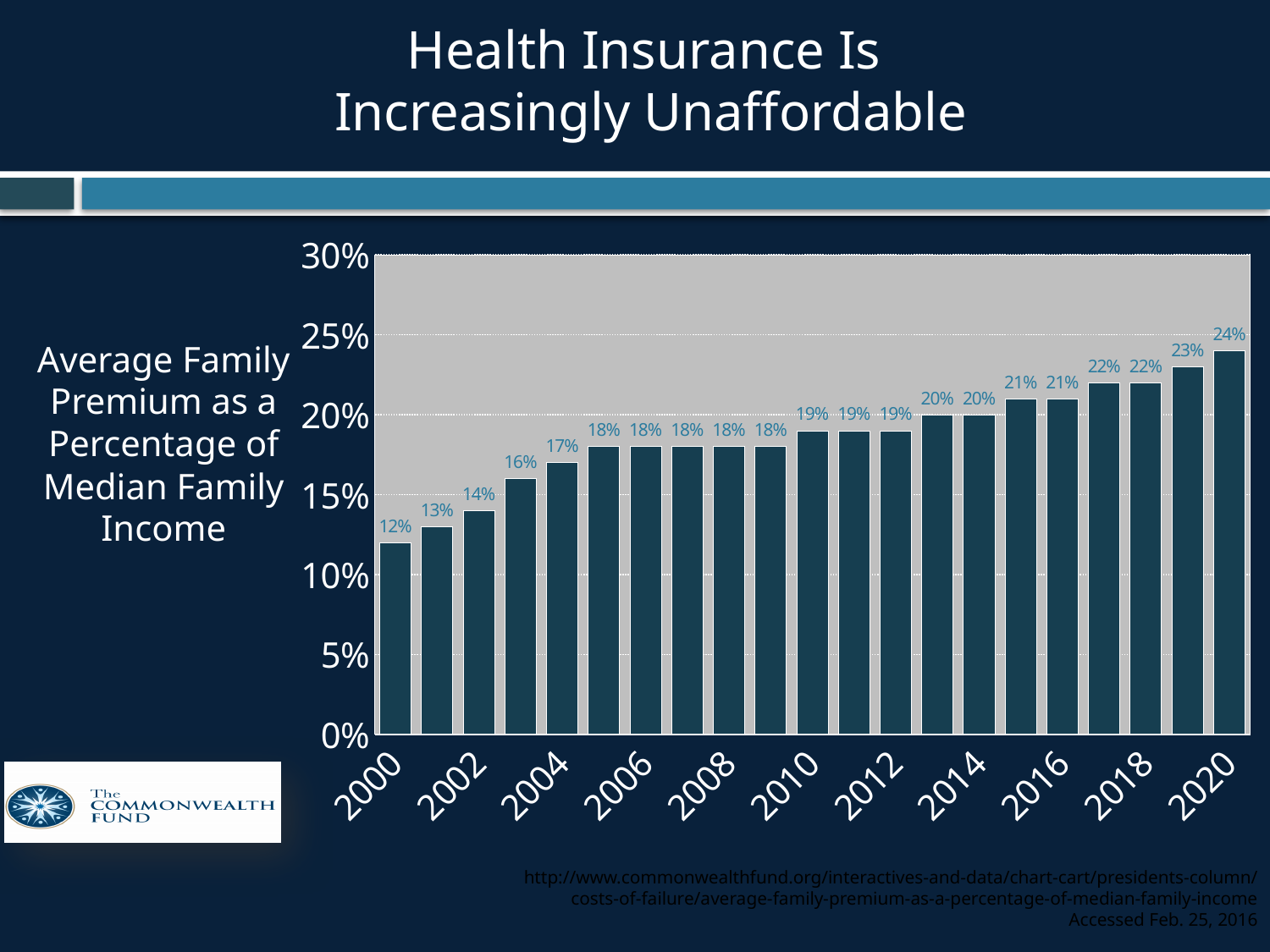
What is the value for 2010? 19% How many bars are plotted in the chart? 21 What kind of chart is shown on the slide? Bar chart What is the difference between the values for 2020 and 2000? 12% Do the values rise or fall from 2000 to 2020? Rise What is the value for 2000? 12% What is the value for 2020? 24% Which year has the lowest value? 2000 Which is larger, the value for 2016 or the value for 2006? 2016 Is the value for 2014 greater or less than 15%? greater Which year has the highest value? 2020 What is the value for 2004? 17%